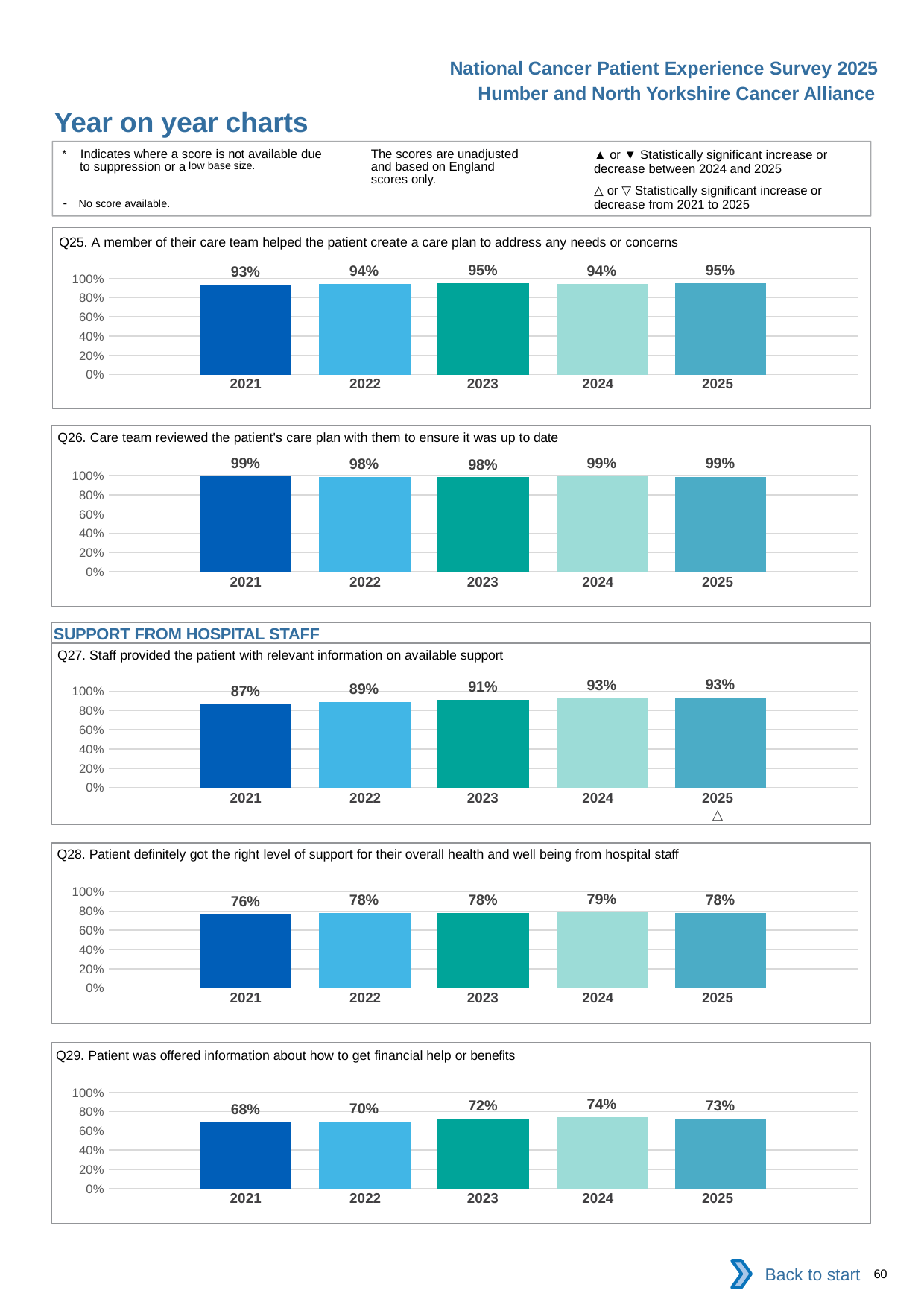
In the Q26 chart, what is the value for 2022? 98% In the Q27 chart, do the values rise or fall from 2021 to 2024? rise In the Q27 chart, what is the difference between the 2025 value and the 2021 value? 6% How many years are shown in the Q25 chart? 5 In the Q29 chart, is the value for 2021 greater or less than 80%? less In the Q29 chart, what is the difference between the 2024 value and the 2025 value? 1% In the Q27 chart, which year has the lowest value? 2021 In the Q28 chart, what is the value for 2021? 76% In the Q29 chart, which is larger, the value for 2024 or the value for 2021? 2024 In the Q25 chart, what is the value for 2023? 95% In the Q28 chart, which year has the highest value? 2024 What kind of chart is the Q28 chart? bar chart